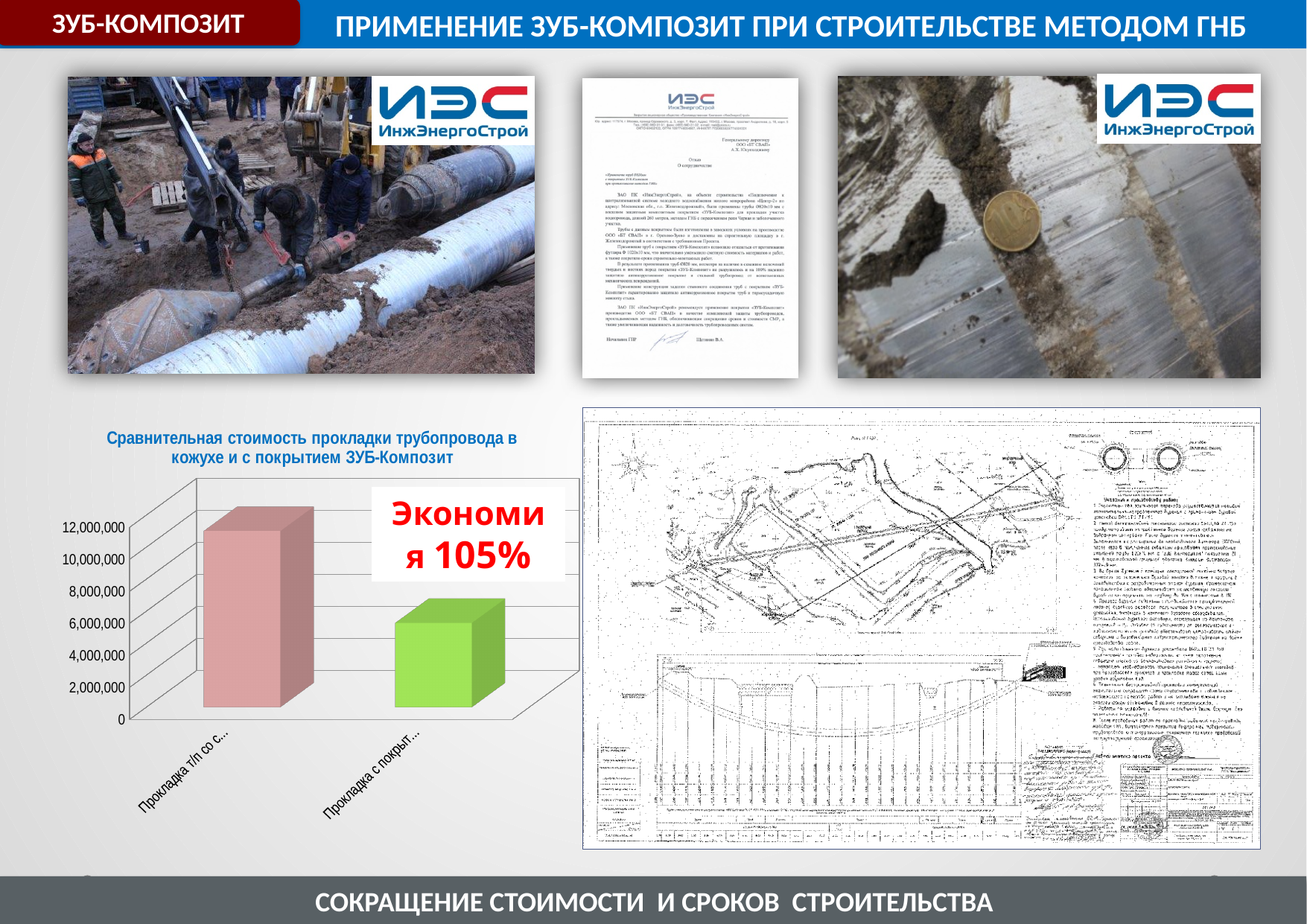
Is the value of the pink bar larger or smaller than the value of the green bar? larger Which bar is the highest in the chart: the left (pink) bar or the right (green) bar? the left (pink) bar What kind of chart is shown on the slide? bar chart Which bar is the lowest in the chart: the left (pink) bar or the right (green) bar? the right (green) bar Is the value of the right (green) bar greater or less than 8,000,000? less Is the value of the right (green) bar greater or less than 4,000,000? greater Do the bar values rise or fall from left to right along the x axis? fall Is the value of the left (pink) bar greater or less than 10,000,000? greater What is the title of the chart? Сравнительная стоимость прокладки трубопровода в кожухе и с покрытием ЗУБ-Композит How many bars does the chart contain? 2 What savings percentage is printed in the red text box over the chart? 105%